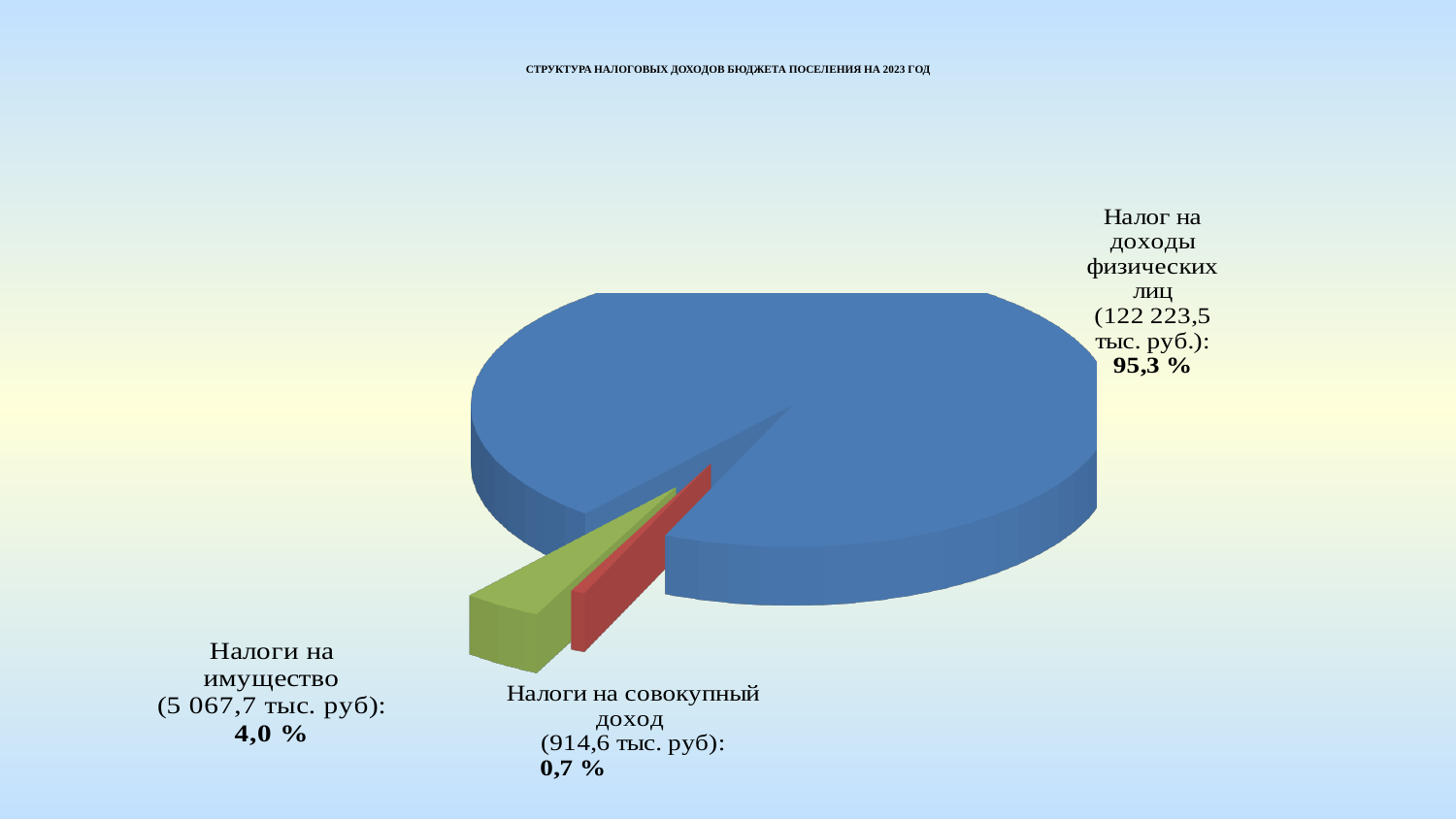
Какая категория имеет наибольшую долю в структуре налоговых доходов? Налог на доходы физических лиц Какова сумма налогов на совокупный доход? 914,6 тыс. руб На сколько процентных пунктов доля налогов на имущество больше доли налогов на совокупный доход? 3,3 % Сколько категорий показано на круговой диаграмме? 3 Какой тип диаграммы показан на слайде? Круговая диаграмма Какова доля налога на доходы физических лиц в структуре налоговых доходов? 95,3 % Как называется диаграмма на слайде? СТРУКТУРА НАЛОГОВЫХ ДОХОДОВ БЮДЖЕТА ПОСЕЛЕНИЯ НА 2023 ГОД Какая категория имеет наименьшую долю в структуре налоговых доходов? Налоги на совокупный доход Какова сумма налога на доходы физических лиц, указанная на диаграмме? 122 223,5 тыс. руб. Какова доля налогов на совокупный доход? 0,7 % Что больше: доля налогов на имущество или доля налогов на совокупный доход? Налоги на имущество Какова сумма налогов на имущество, указанная на диаграмме? 5 067,7 тыс. руб